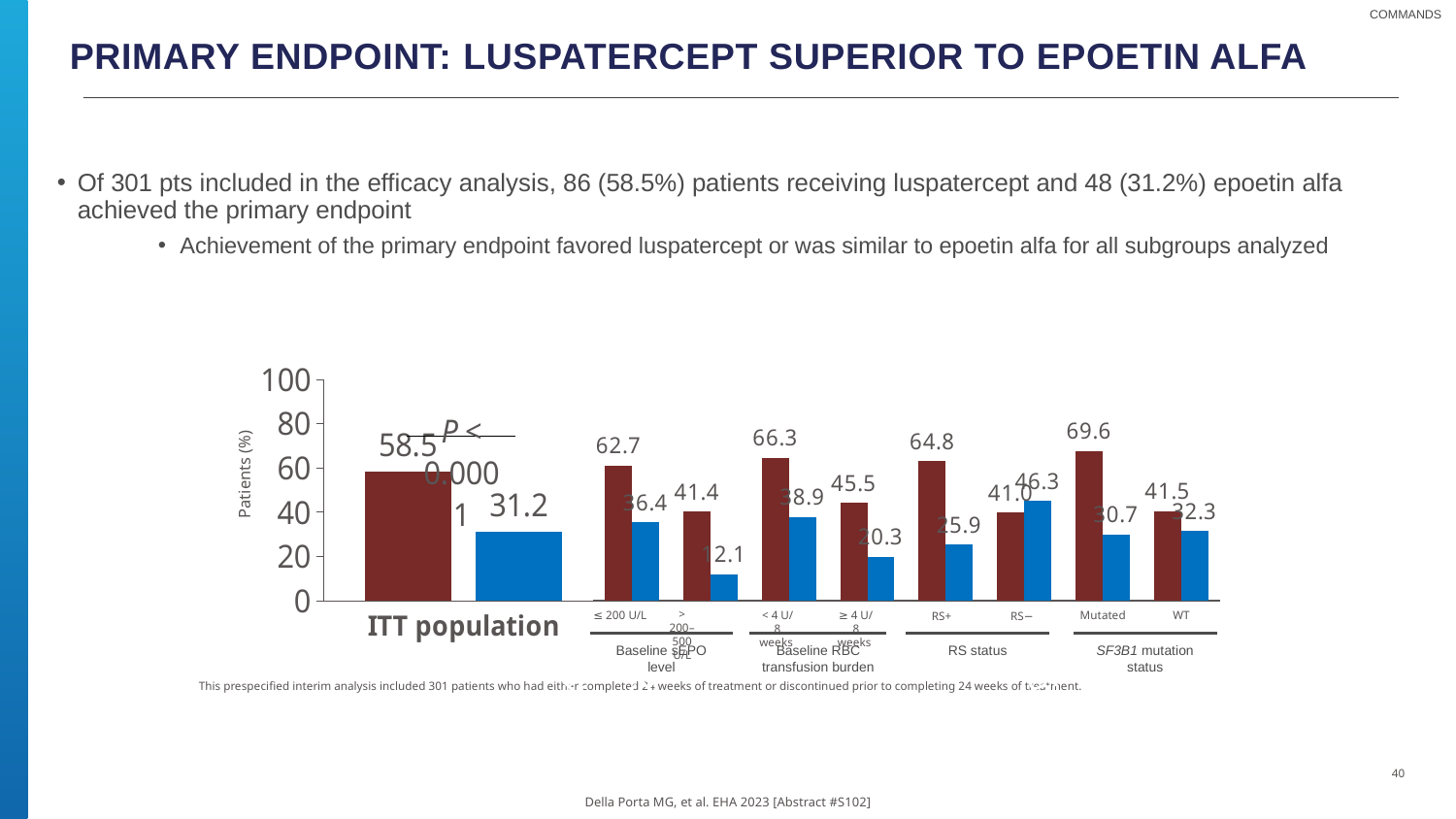
What is the value of the blue bar for the ITT population? 31.2 What is the label of the y-axis of the chart? Patients (%) What is the value of the blue bar for the ≥ 4 U/8 weeks baseline RBC transfusion burden subgroup? 20.3 Which subgroup has the lowest blue bar value? > 200–500 U/L (baseline sEPO level) Which subgroup has the highest dark red bar value? Mutated (SF3B1 mutation status) What is the difference between the dark red bar values for the Mutated and WT SF3B1 subgroups? 28.1 What is the value of the dark red bar for the RS+ subgroup? 64.8 What is the value of the dark red bar for the ITT population? 58.5 Is the dark red bar value for the < 4 U/8 weeks subgroup greater or less than 60? greater In the RS− subgroup, which bar is larger, the dark red bar or the blue bar? the blue bar What is the difference between the dark red and blue bar values for the ITT population? 27.3 What type of chart is shown on the slide? bar chart